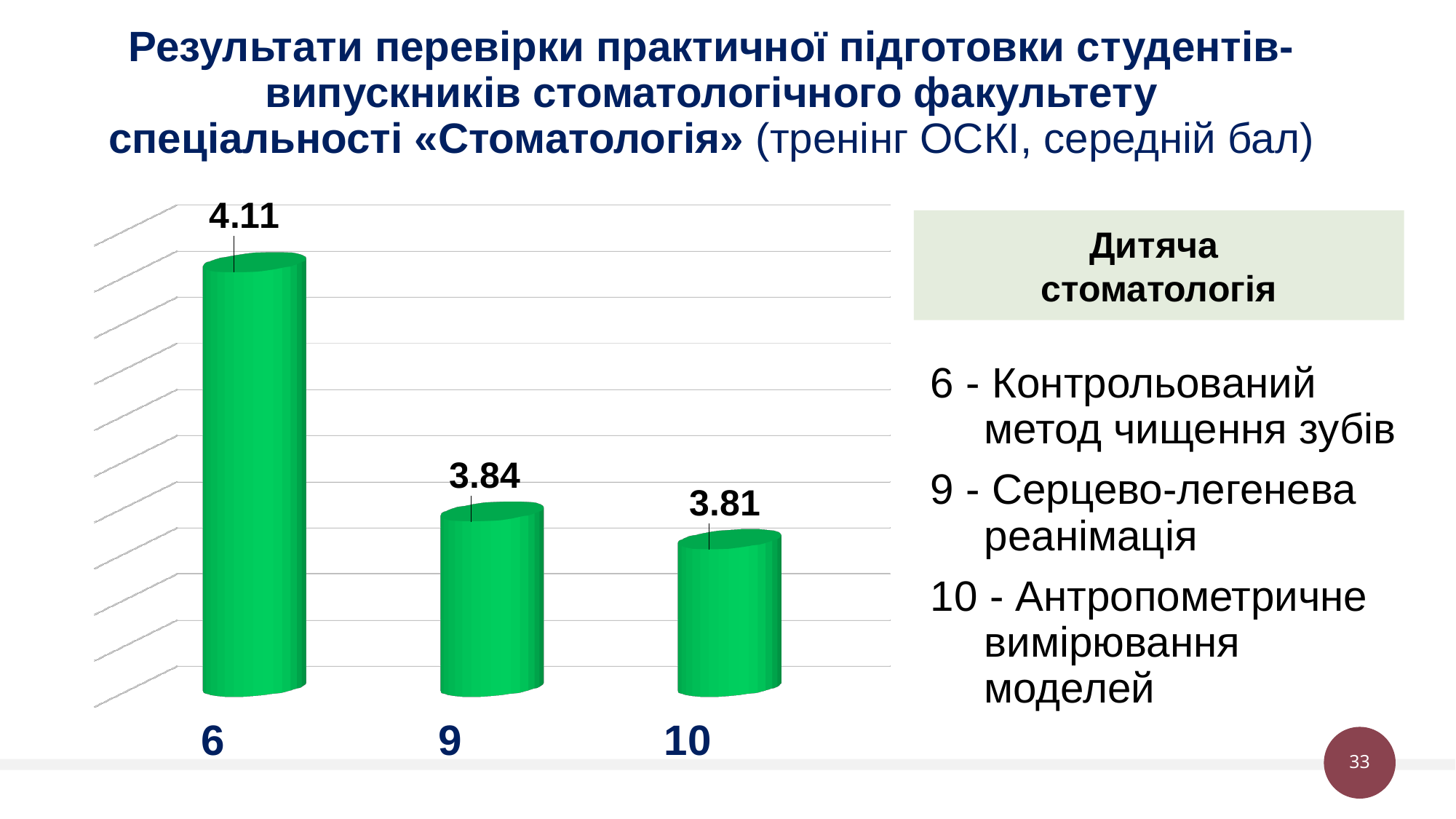
Which is larger, the value for category 6 or the value for category 10? 6 What is the value for category 6? 4.11 What is the difference between the values for category 9 and category 10? 0.03 What kind of chart is shown on the slide? bar chart What is the value for category 9? 3.84 What is the value for category 10? 3.81 Which category has the lowest value? 10 How many bars are shown in the chart? 3 Which category has the highest value? 6 What is the difference between the values for category 6 and category 10? 0.30 What is the difference between the values for category 6 and category 9? 0.27 Do the values rise or fall from left to right across the categories? fall